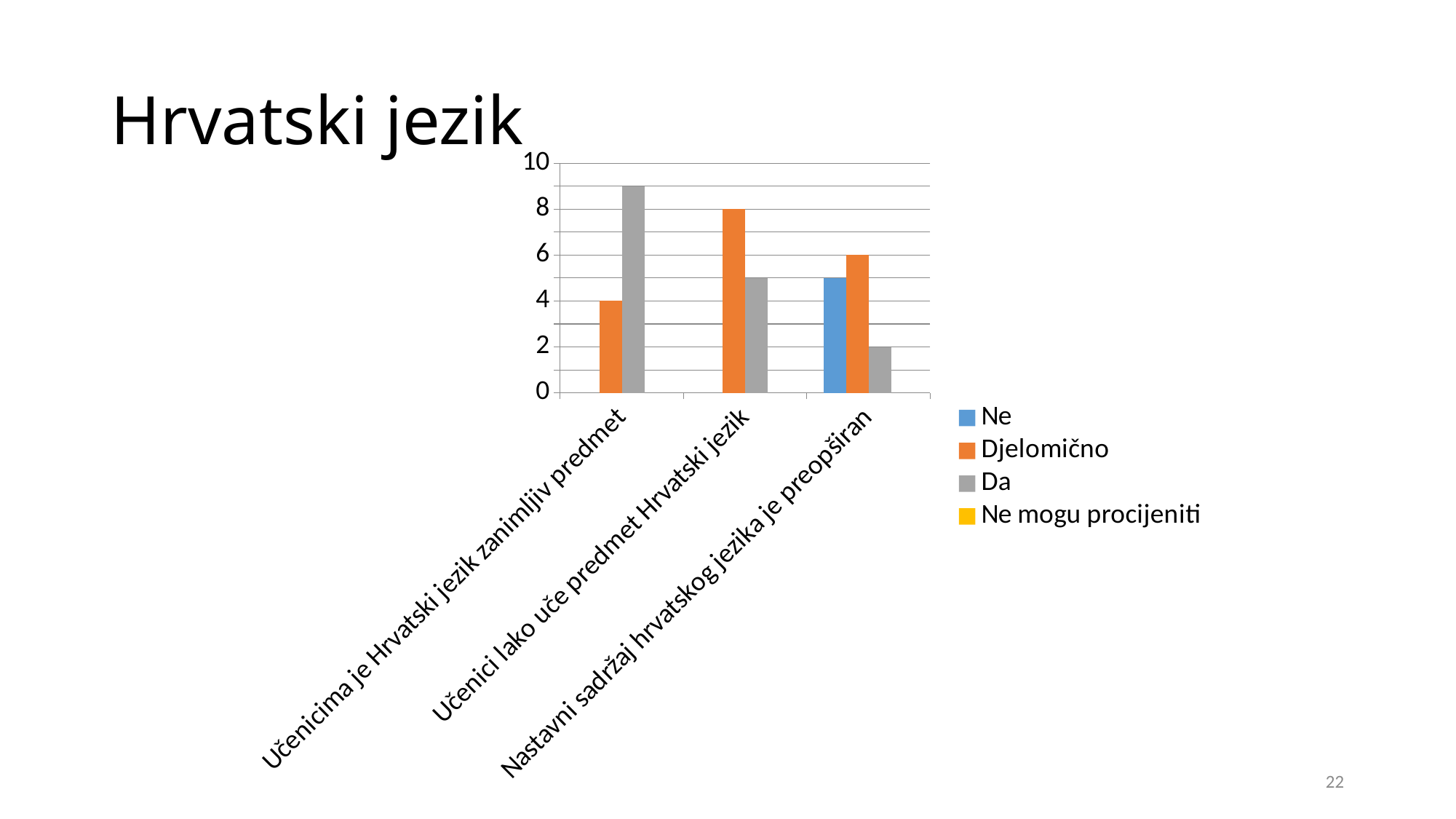
What is the value of Djelomično for 'Učenicima je Hrvatski jezik zanimljiv predmet'? 4 What kind of chart is shown on the slide? bar chart How many series does the legend list? 4 What is the value of Djelomično for 'Nastavni sadržaj hrvatskog jezika je preopširan'? 6 Is the value of Ne for 'Nastavni sadržaj hrvatskog jezika je preopširan' greater or less than 6? less What is the difference between the Djelomično values for 'Učenici lako uče predmet Hrvatski jezik' and 'Učenicima je Hrvatski jezik zanimljiv predmet'? 4 How many categories are shown on the x axis? 3 Which category has the lowest Da value? Nastavni sadržaj hrvatskog jezika je preopširan Which category has the highest Djelomično value? Učenici lako uče predmet Hrvatski jezik What is the value of Da for 'Nastavni sadržaj hrvatskog jezika je preopširan'? 2 Is the value of Da for 'Učenicima je Hrvatski jezik zanimljiv predmet' greater or less than 8? greater What is the value of Djelomično for 'Učenici lako uče predmet Hrvatski jezik'? 8